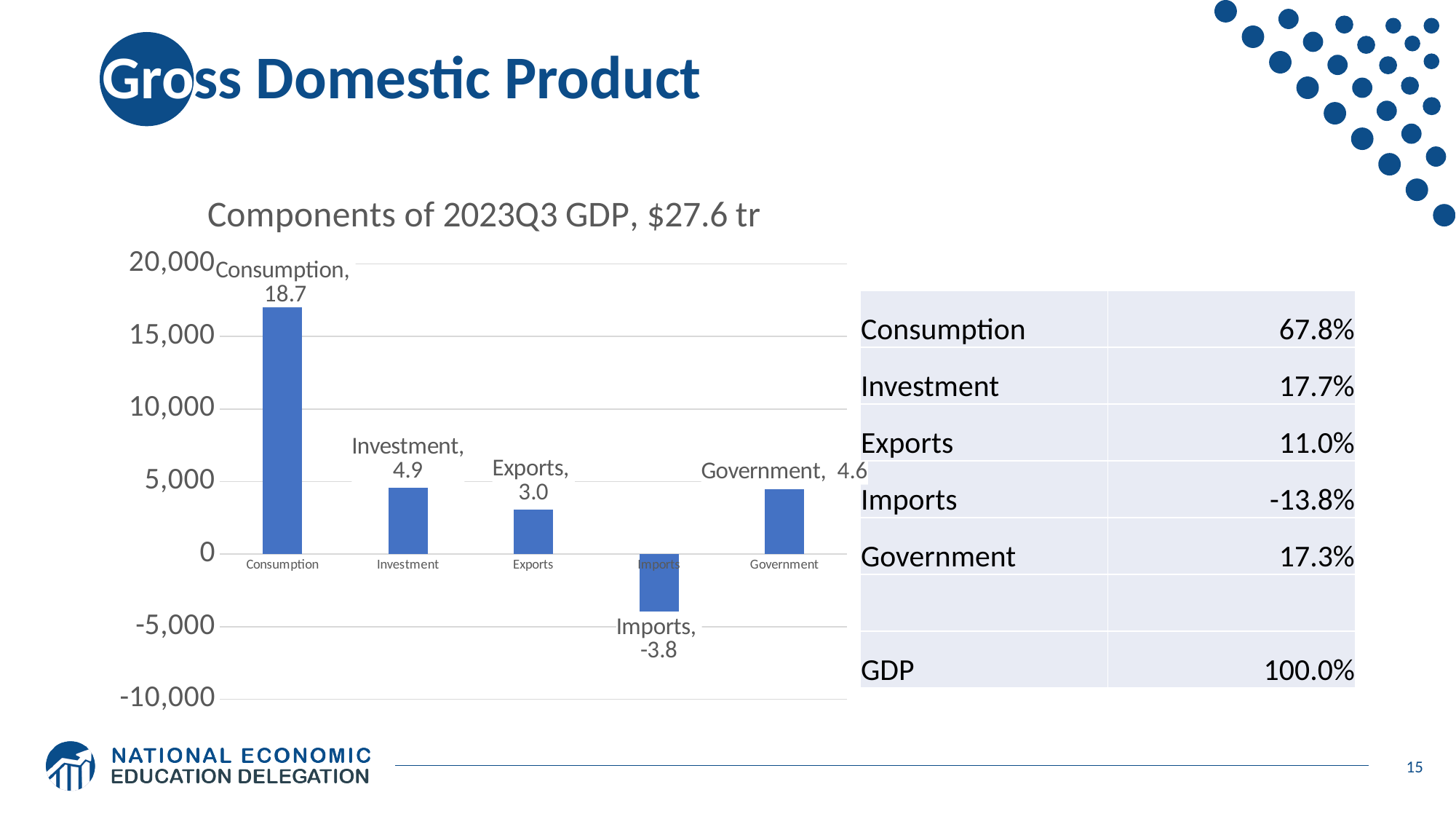
Which component has the lowest bar in the chart? Imports How many components are plotted in the chart? 5 What is the title of the chart? Components of 2023Q3 GDP, $27.6 tr What is the difference between the labeled values for Consumption and Investment? 13.8 What is the data label value for Investment in the chart? 4.9 What is the data label value for Imports in the chart? -3.8 What is the data label value for Consumption in the chart? 18.7 Is the bar for Consumption greater or less than 15,000 on the axis? greater Which is larger according to the data labels, Exports or Government? Government What is the data label value for Government in the chart? 4.6 What is the difference between the labeled values for Investment and Government? 0.3 Which component has the highest bar in the chart? Consumption